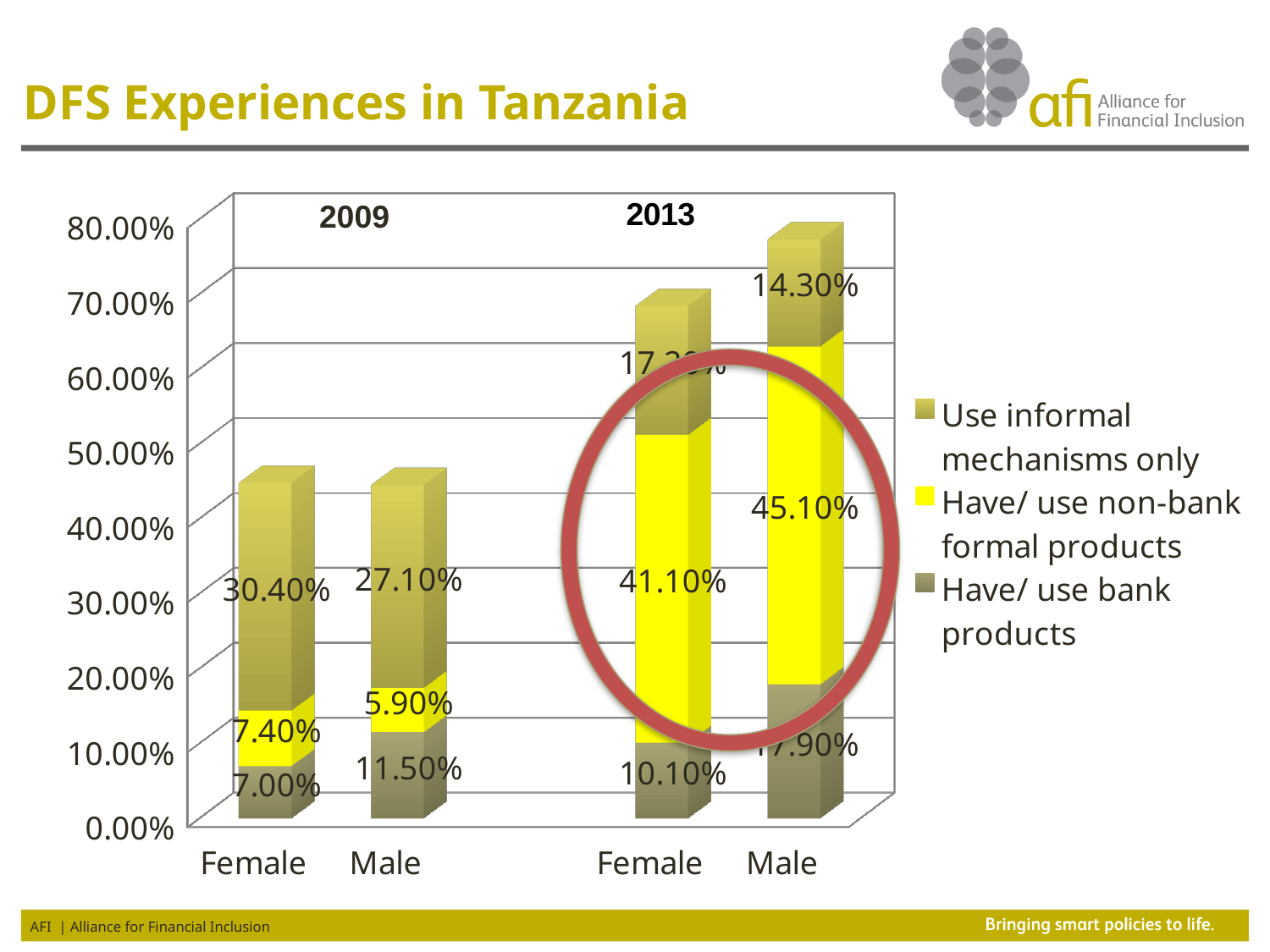
How many series does the legend list? 3 Is the total height of the Male 2013 stacked bar greater or less than 70.00%? greater What is the value for 'Use informal mechanisms only' for Female in 2009? 30.40% What is the value for 'Have/ use non-bank formal products' for Female in 2013? 41.10% What is the value for 'Use informal mechanisms only' for Male in 2013? 14.30% Which bar has the highest 'Have/ use non-bank formal products' value? Male 2013 How many stacked bars are plotted on the chart? 4 What is the value for 'Have/ use bank products' for Male in 2009? 11.50% What is the value for 'Have/ use non-bank formal products' for Male in 2013? 45.10% What is the difference between the 'Have/ use non-bank formal products' values for Male and Female in 2013? 4.00% In 2009, which group has the larger 'Use informal mechanisms only' value, Female or Male? Female What is the total of the stacked bar for Female in 2009? 44.80%